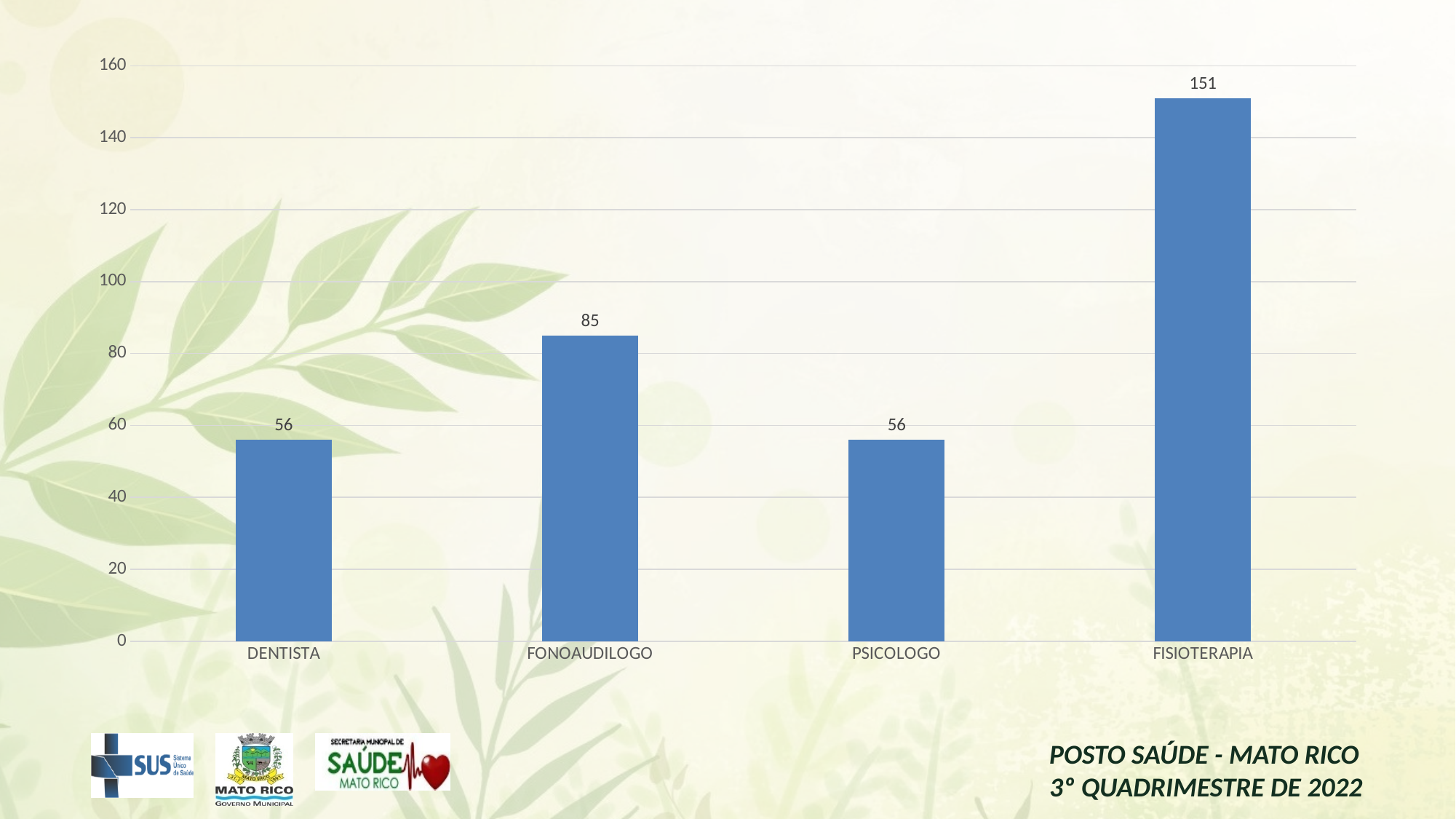
What is the difference between the values for FONOAUDILOGO and DENTISTA? 29 What is the highest value shown on the vertical axis? 160 Which category has the highest value? FISIOTERAPIA What is the value for FISIOTERAPIA? 151 Is the value for FISIOTERAPIA greater or less than 140? greater How many categories are shown on the x axis? 4 What is the value for DENTISTA? 56 What is the difference between the values for FISIOTERAPIA and FONOAUDILOGO? 66 What kind of chart is shown on the slide? bar chart Which is larger, the value for FONOAUDILOGO or the value for PSICOLOGO? FONOAUDILOGO What is the value for PSICOLOGO? 56 What is the value for FONOAUDILOGO? 85